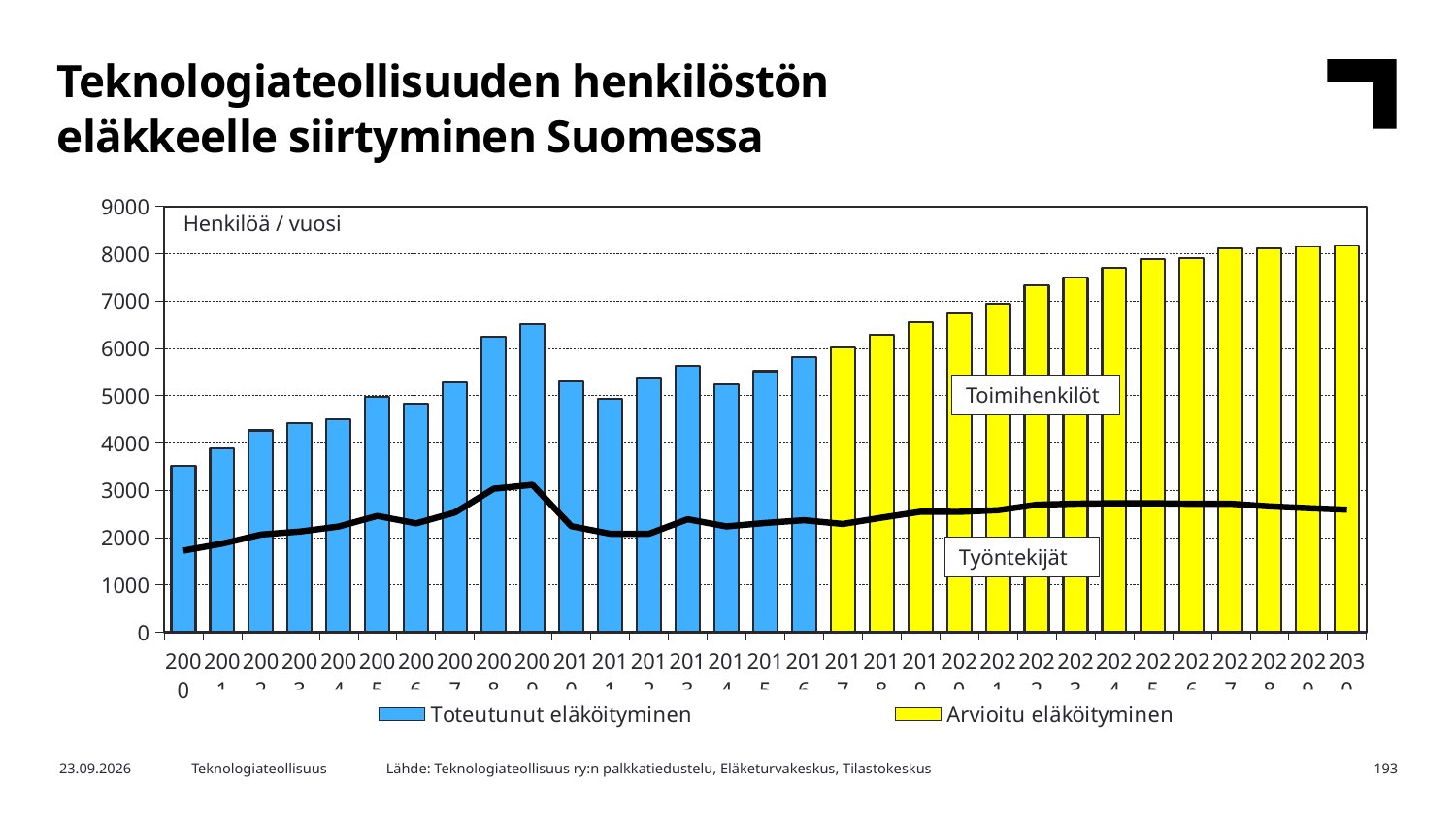
What unit label is printed inside the top left of the plot area? Henkilöä / vuosi Do the yellow (Arvioitu eläköityminen) bars rise or fall from 2017 to 2030? rise How many series does the legend list? 2 Is the bar for 2009 greater or less than 6000? greater Is the bar for 2016 greater or less than 6000? less What kind of chart is shown on the slide? combination bar and line chart Is the bar for 2030 greater or less than 8000? greater Which legend entry is shown in blue? Toteutunut eläköityminen How many years are shown along the x axis? 31 Which bar is taller, 2009 or 2010? 2009 Which year has the lowest bar? 2000